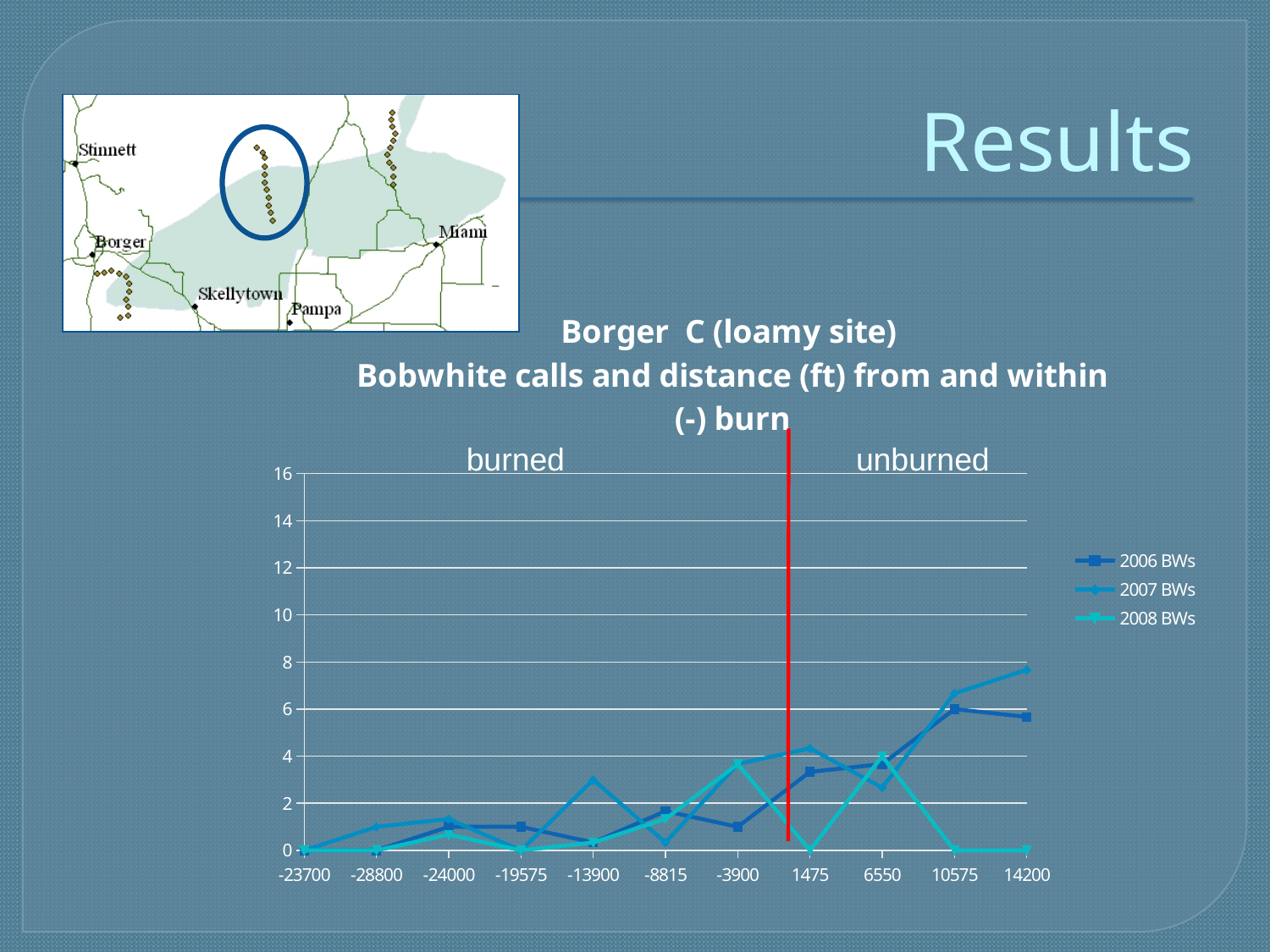
Which series has the highest value at 14200? 2007 BWs How many distance categories are shown along the x axis? 11 What is the value for 2008 BWs at 1475? 0 Is the value for 2008 BWs at -13900 greater or less than 2? less What are the two region labels shown on either side of the red vertical line? burned and unburned Is the value for 2007 BWs at 14200 greater or less than 6? greater At which distance does 2007 BWs reach its highest value? 14200 Is the value for 2006 BWs at 1475 greater or less than 2? greater What kind of chart is shown on the slide? line chart How many series does the legend list? 3 Do the values for 2006 BWs generally rise or fall from left to right along the x axis? rise What is the value for 2008 BWs at 14200? 0